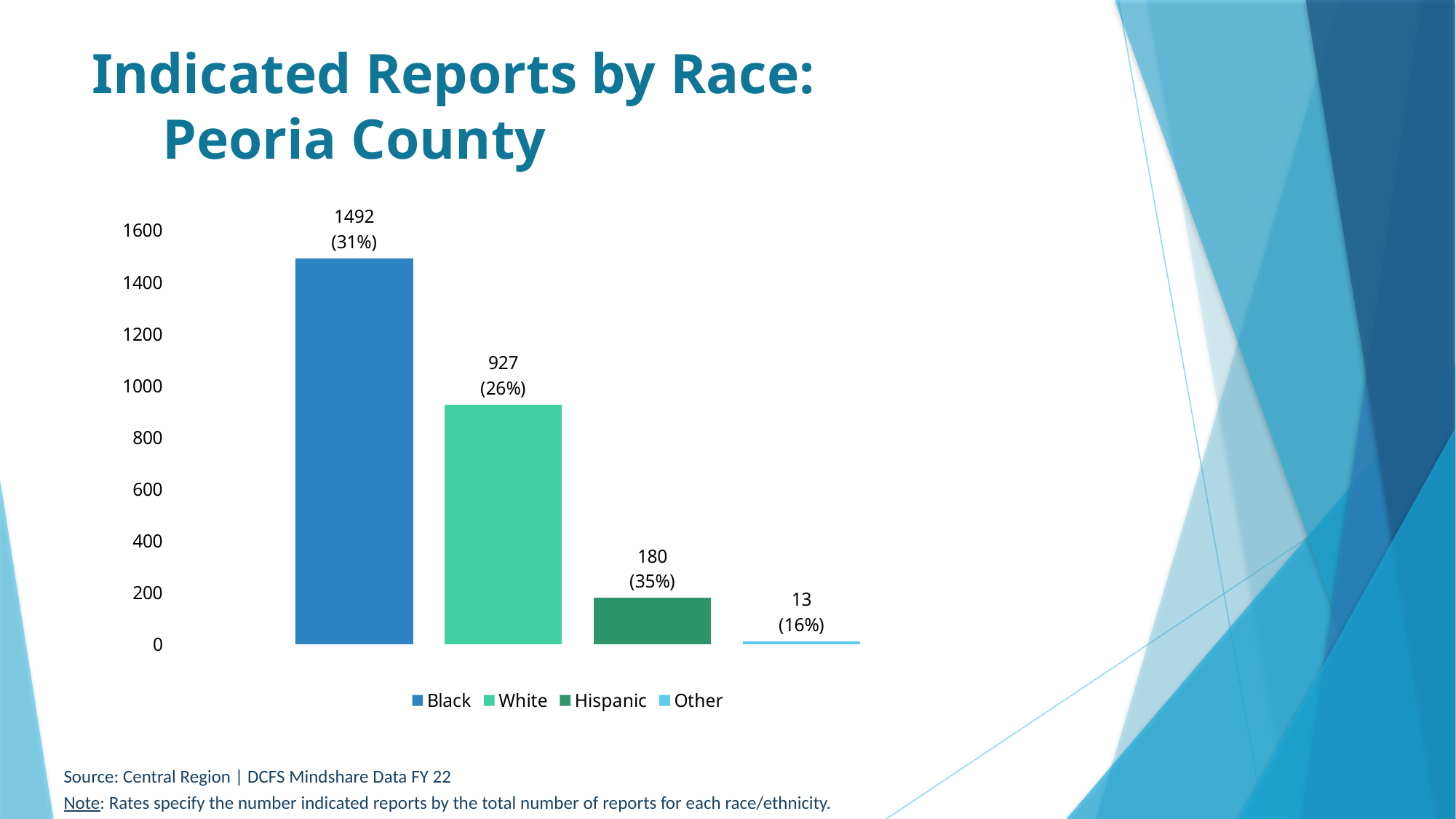
Which race category has the highest number of indicated reports? Black What is the number of indicated reports for Other? 13 What kind of chart is shown on the slide? Bar chart What is the number of indicated reports for Hispanic? 180 Which race category has the lowest number of indicated reports? Other How many race categories are shown in the chart? 4 What is the difference between the number of indicated reports for Black and White? 565 Which has more indicated reports, White or Hispanic? White What is the number of indicated reports for Black in Peoria County? 1492 What is the title of the slide? Indicated Reports by Race: Peoria County What rate (percentage) is shown for Hispanic? 35% What is the number of indicated reports for White? 927